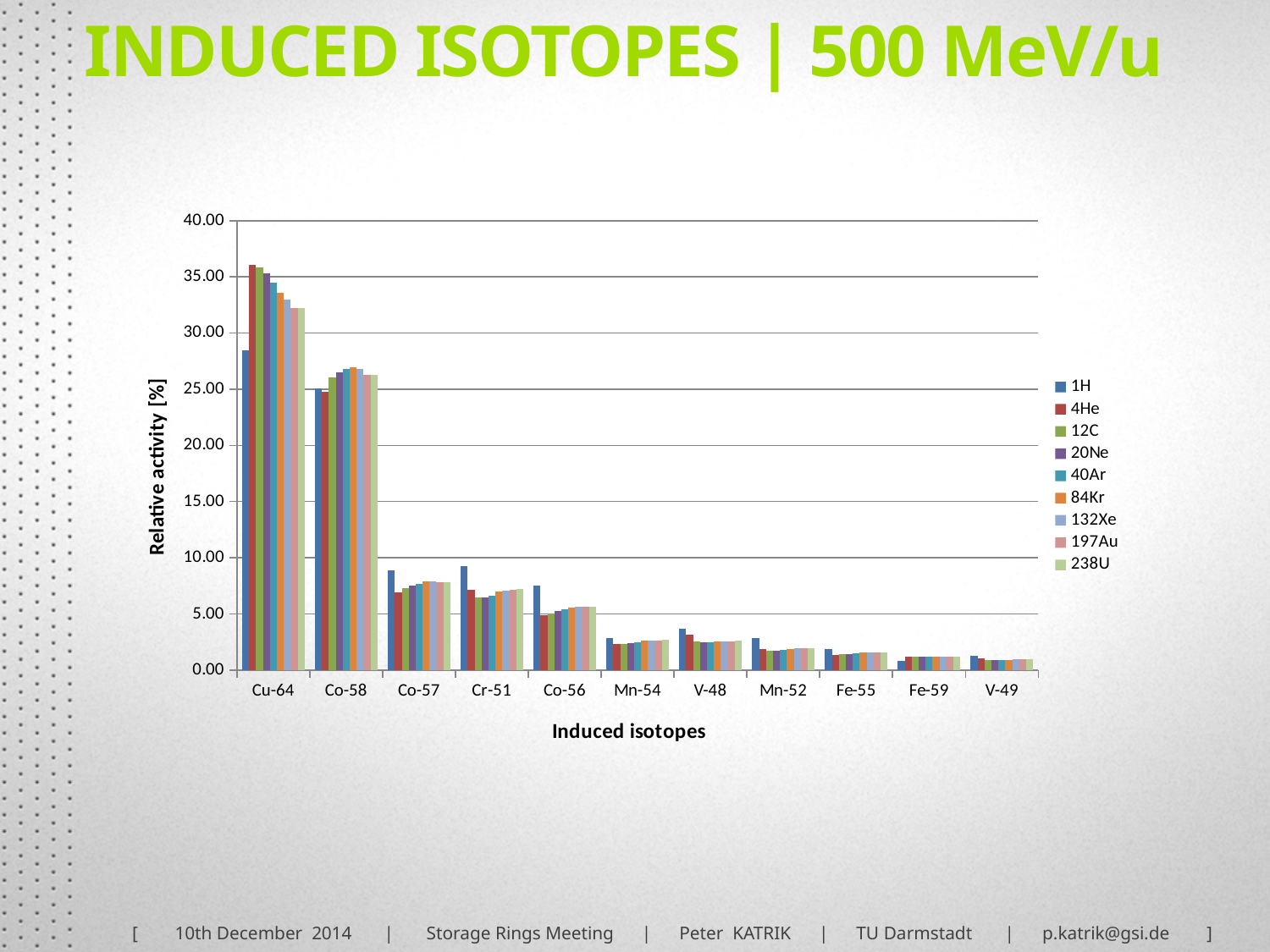
How many induced isotopes (categories) are shown on the x axis? 11 For the 1H series, which has the larger relative activity: Cu-64 or Co-58? Cu-64 Is the relative activity of Mn-54 for the 238U series greater or less than 5.00? less Is the relative activity of Co-58 for the 84Kr series greater or less than 20.00? greater Do the relative activity values generally rise or fall moving from left to right along the x axis? fall Is the relative activity of Cu-64 for the 1H series greater or less than 30.00? less What is the first series listed in the legend? 1H How many series does the legend list? 9 What kind of chart is shown on the slide? bar chart Which induced isotope has the highest relative activity? Cu-64 What is the label of the y axis? Relative activity [%]